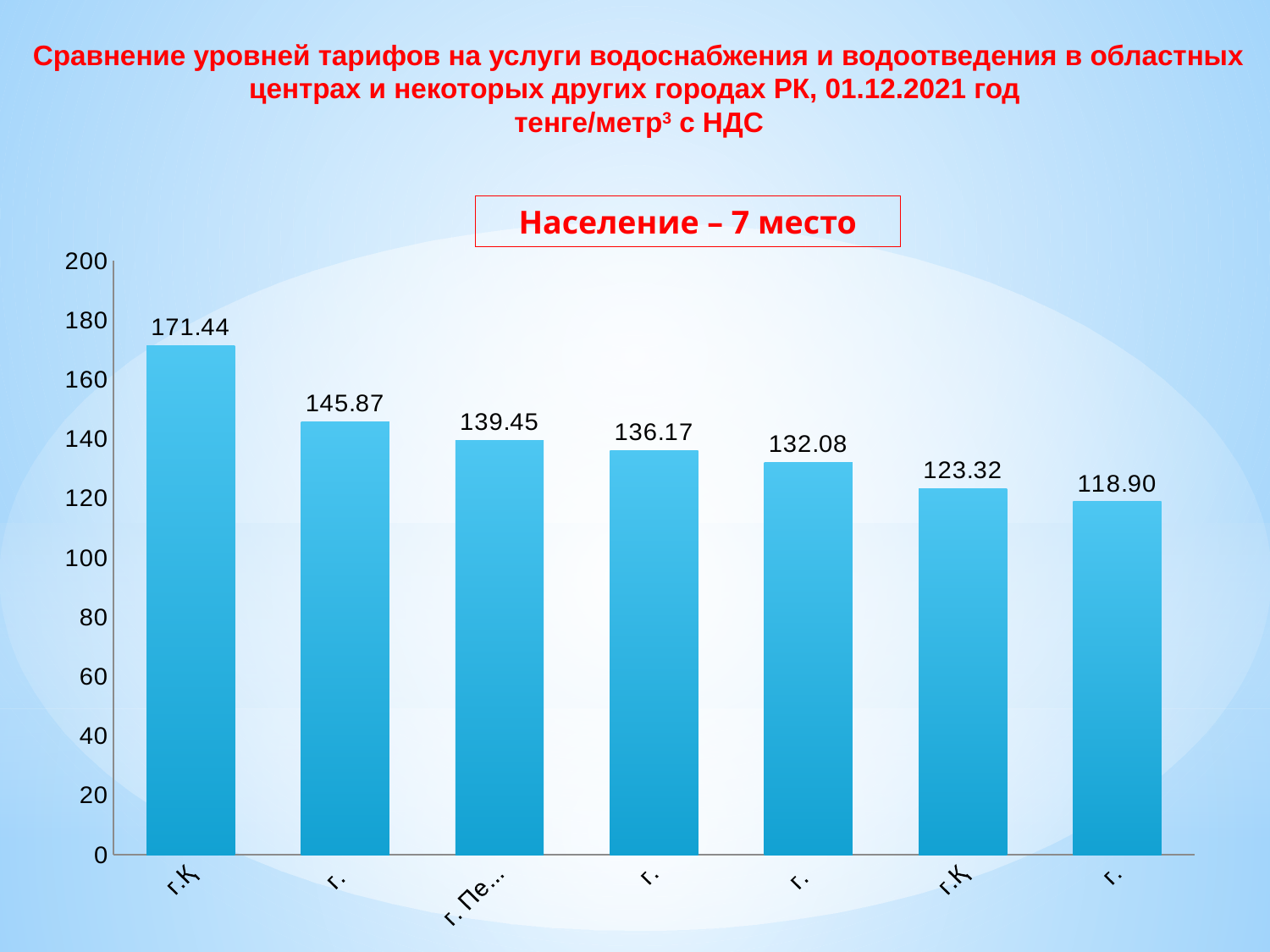
What is the value shown on the fifth bar from the left? 132.08 How many bars are plotted in the chart? 7 Which is larger: the fourth bar or the sixth bar? the fourth bar (136.17) What text is shown in the box above the chart? Население – 7 место What is the difference between the first bar (171.44) and the second bar (145.87)? 25.57 What type of chart is shown on the slide? bar chart What is the value shown on the last (rightmost) bar? 118.90 Do the bar values rise or fall from left to right across the chart? fall What is the highest value shown in the chart? 171.44 What is the lowest value shown in the chart? 118.90 What is the value shown on the third bar from the left? 139.45 What is the value shown on the first (leftmost) bar? 171.44